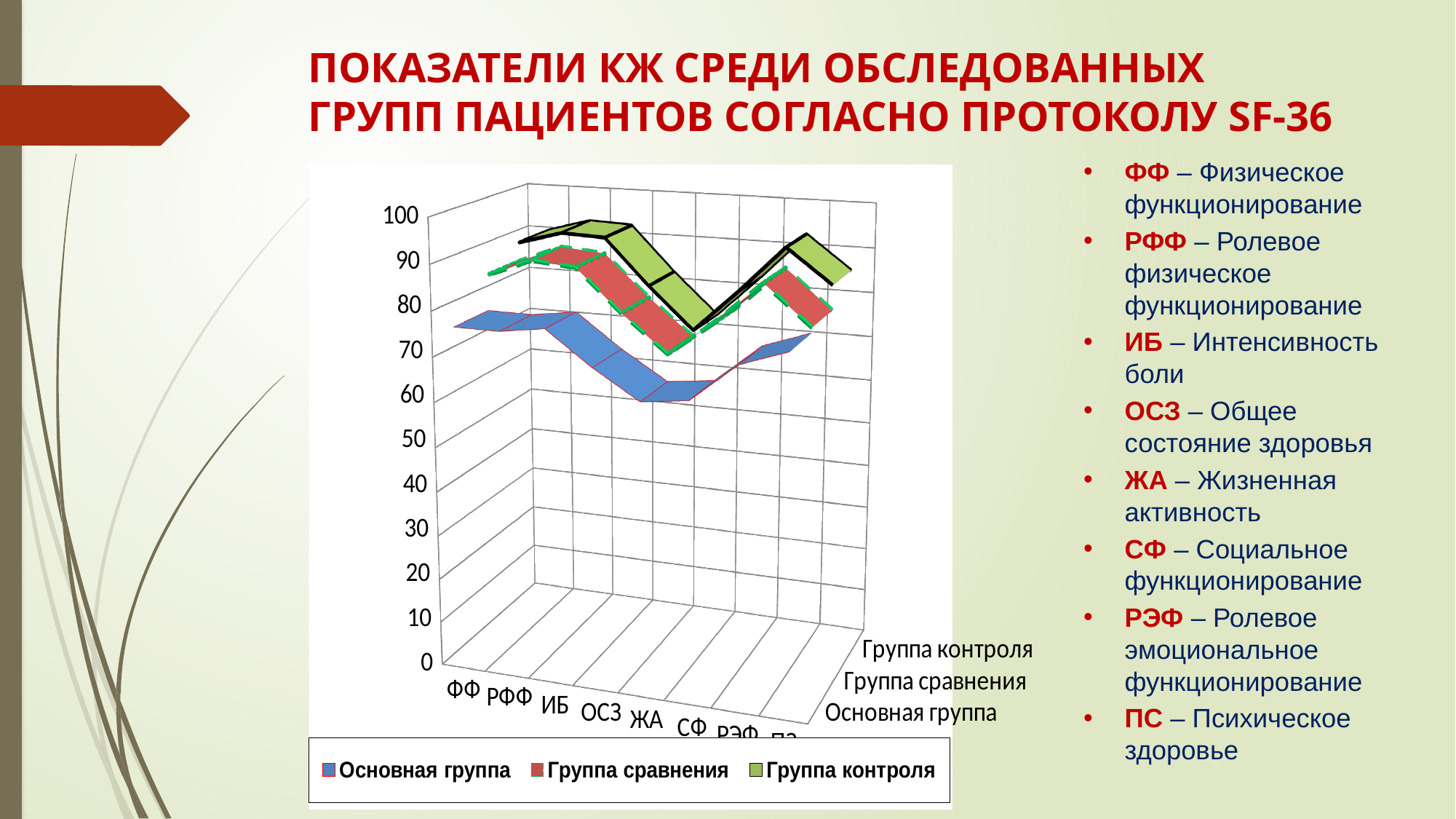
Which series has the lowest values across all categories? Основная группа What kind of chart is shown on the slide? 3D line chart Do the values for Основная группа rise or fall from ФФ to ЖА? fall How many series does the legend list? 3 What is the highest value shown on the vertical axis? 100 Which series is shown in green in the legend? Группа контроля Is the value for ФФ in the Группа контроля series greater or less than 80? greater Which series is shown in blue in the legend? Основная группа Which series has the lower value for РФФ, Основная группа or Группа сравнения? Основная группа Which series has the higher value for ФФ, Основная группа or Группа контроля? Группа контроля Is the value for ФФ in the Основная группа series greater or less than 80? less Is the value for ЖА in the Основная группа series greater or less than 70? less